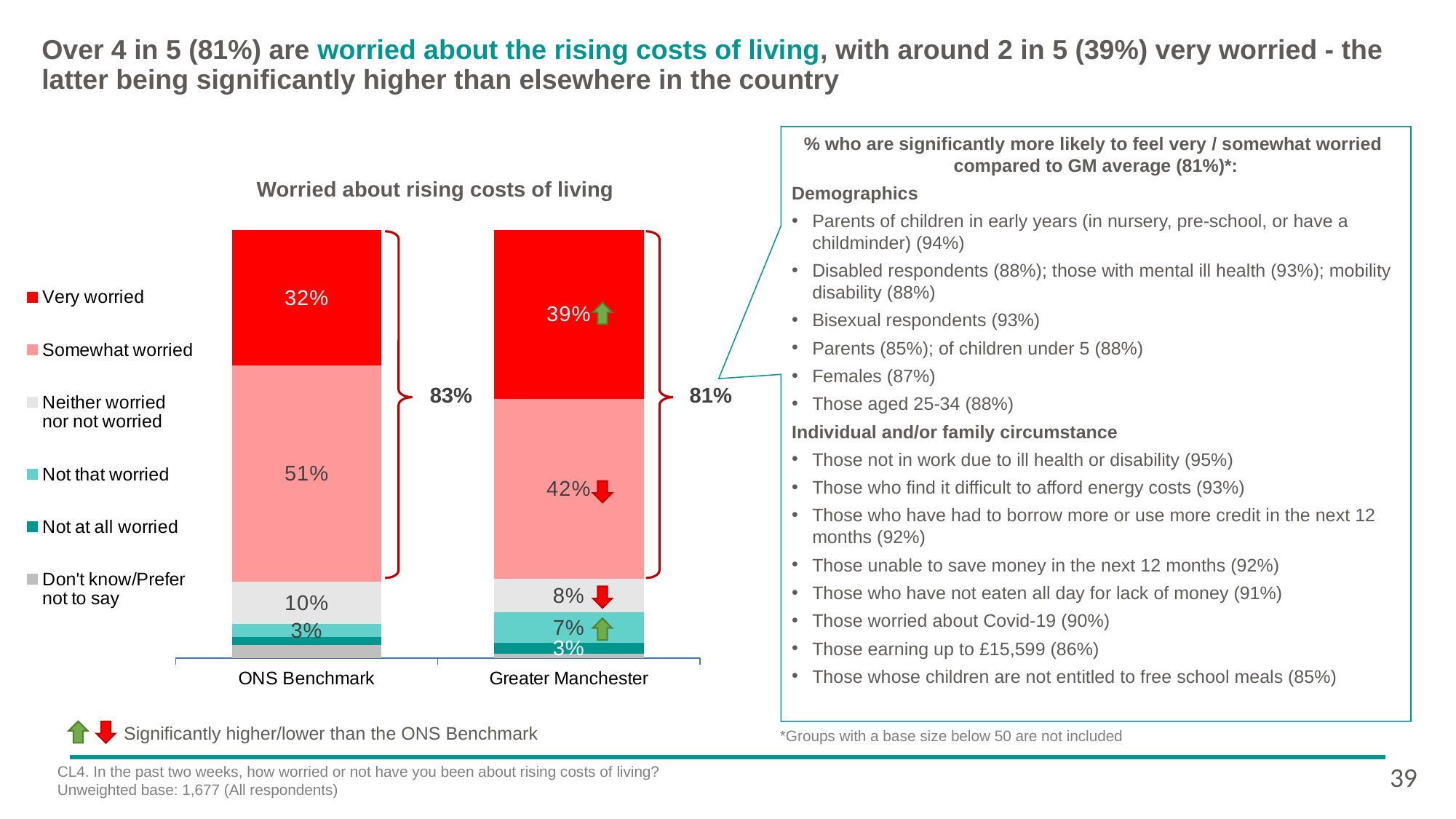
How many categories are shown on the x axis? 2 Which category has the higher 'Very worried' value, ONS Benchmark or Greater Manchester? Greater Manchester What is the 'Somewhat worried' value for Greater Manchester? 42% What is the difference between the 'Somewhat worried' values for the ONS Benchmark and Greater Manchester? 9 percentage points What is the 'Somewhat worried' value for the ONS Benchmark? 51% What is the 'Very worried' value for the ONS Benchmark? 32% What is the 'Not that worried' value for Greater Manchester? 7% What is the combined 'Very worried' and 'Somewhat worried' share shown by the bracket for Greater Manchester? 81% How many series does the legend list? 6 What is the 'Neither worried nor not worried' value for Greater Manchester? 8% What type of chart is shown on the slide? Stacked bar chart What is the 'Very worried' value for Greater Manchester? 39%